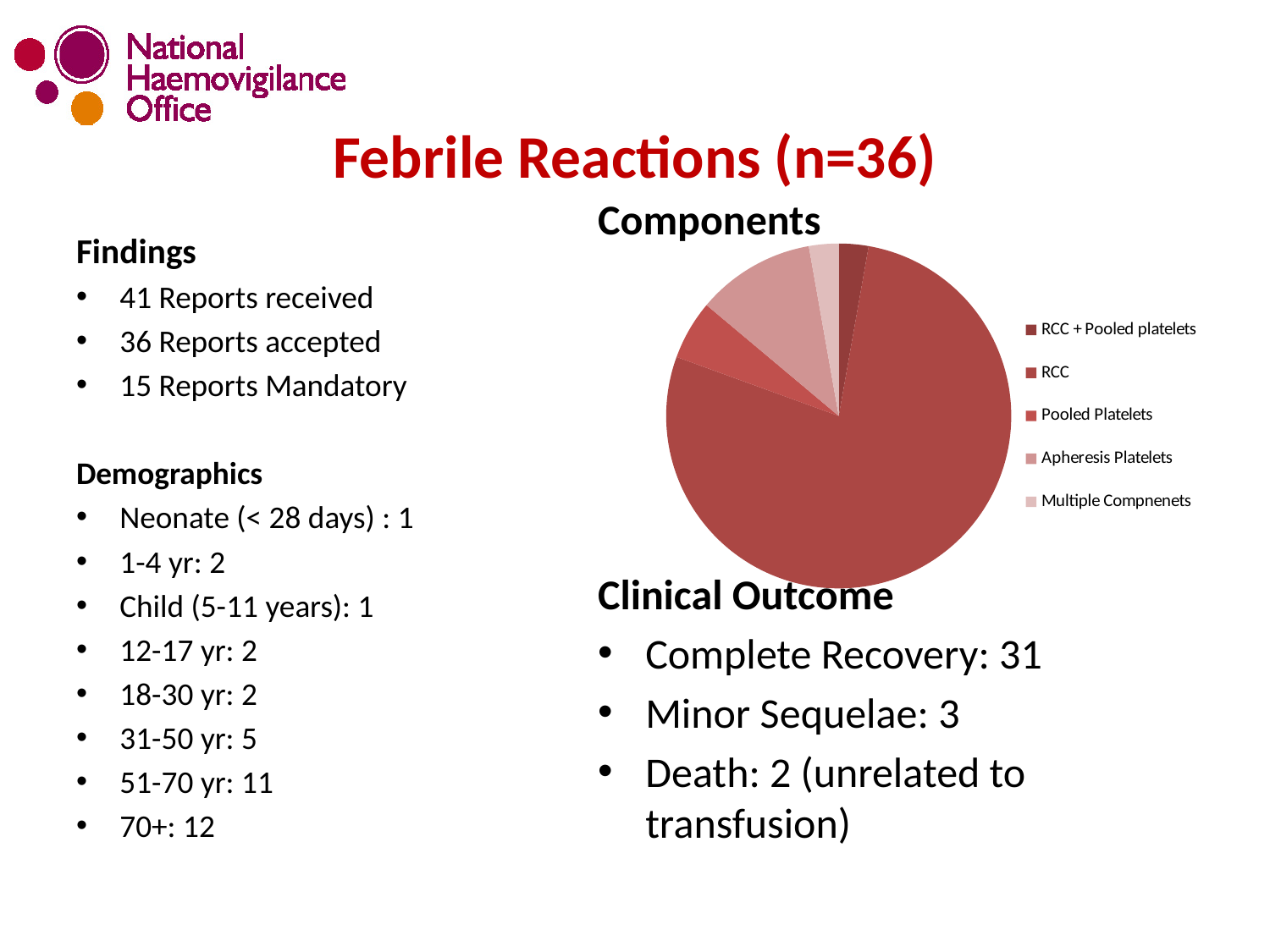
How many categories does the legend of the "Components" pie chart list? 5 In the "Components" pie chart, which slice is larger: RCC or RCC + Pooled platelets? RCC What is the first legend entry of the "Components" pie chart? RCC + Pooled platelets What is the title of the pie chart on the slide? Components Which component has the largest slice in the "Components" pie chart? RCC In the "Components" pie chart, which slice is larger: RCC or Pooled Platelets? RCC In the "Components" pie chart, which slice is larger: RCC or Apheresis Platelets? RCC What kind of chart is the "Components" chart? pie chart